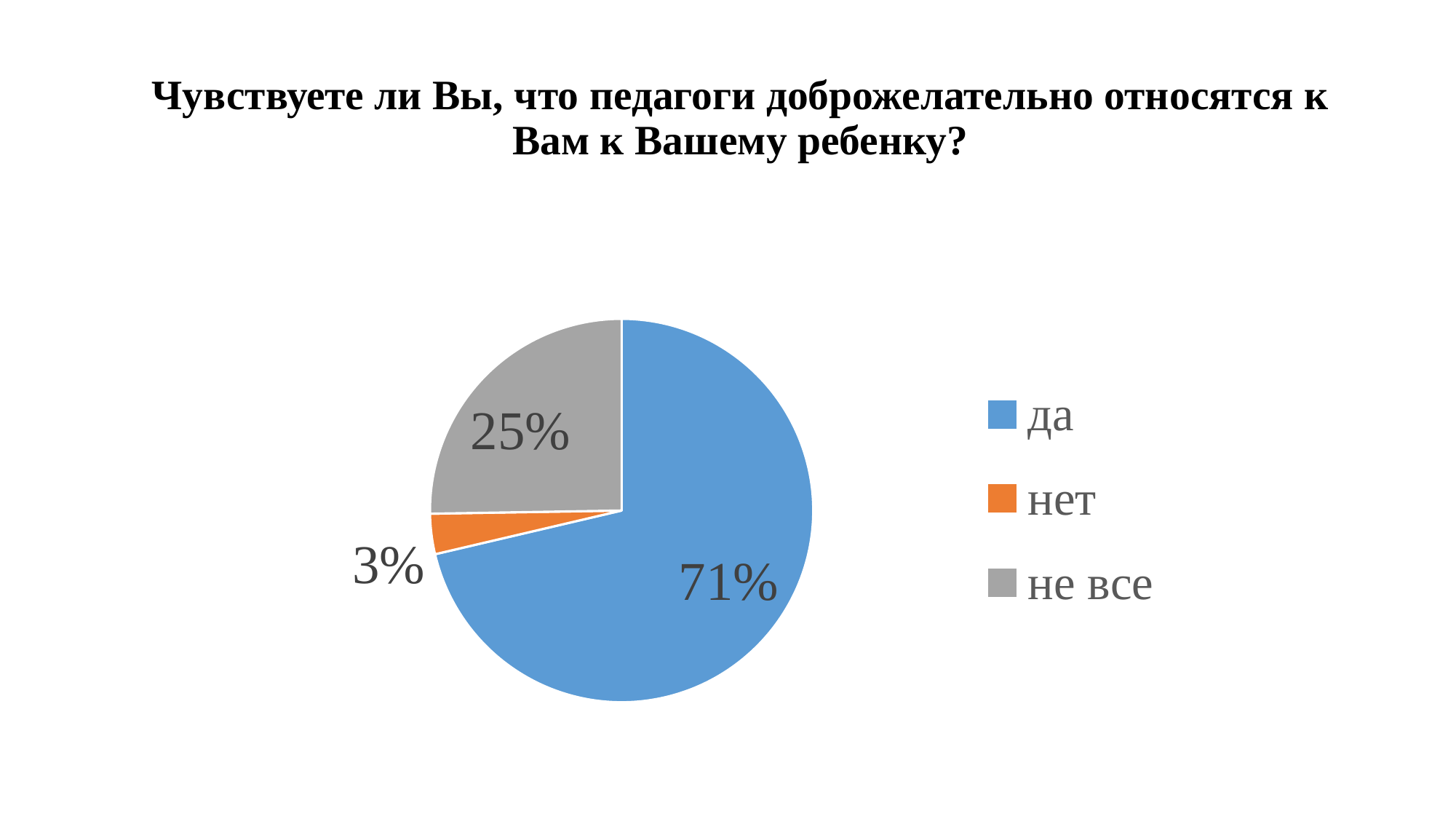
What is the difference in percentage points between "да" and "не все"? 46 What colour is the slice for "нет"? orange What share of the pie does "да" take? 71% What share of the pie does "не все" take? 25% What share of the pie does "нет" take? 3% How many entries does the legend list? 3 What kind of chart is shown on the slide? pie chart What is the difference in percentage points between "не все" and "нет"? 22 Which category has the largest slice of the pie? да How many slices does the pie chart have? 3 Which category has the smallest slice of the pie? нет Which is larger, the share for "не все" or the share for "нет"? не все